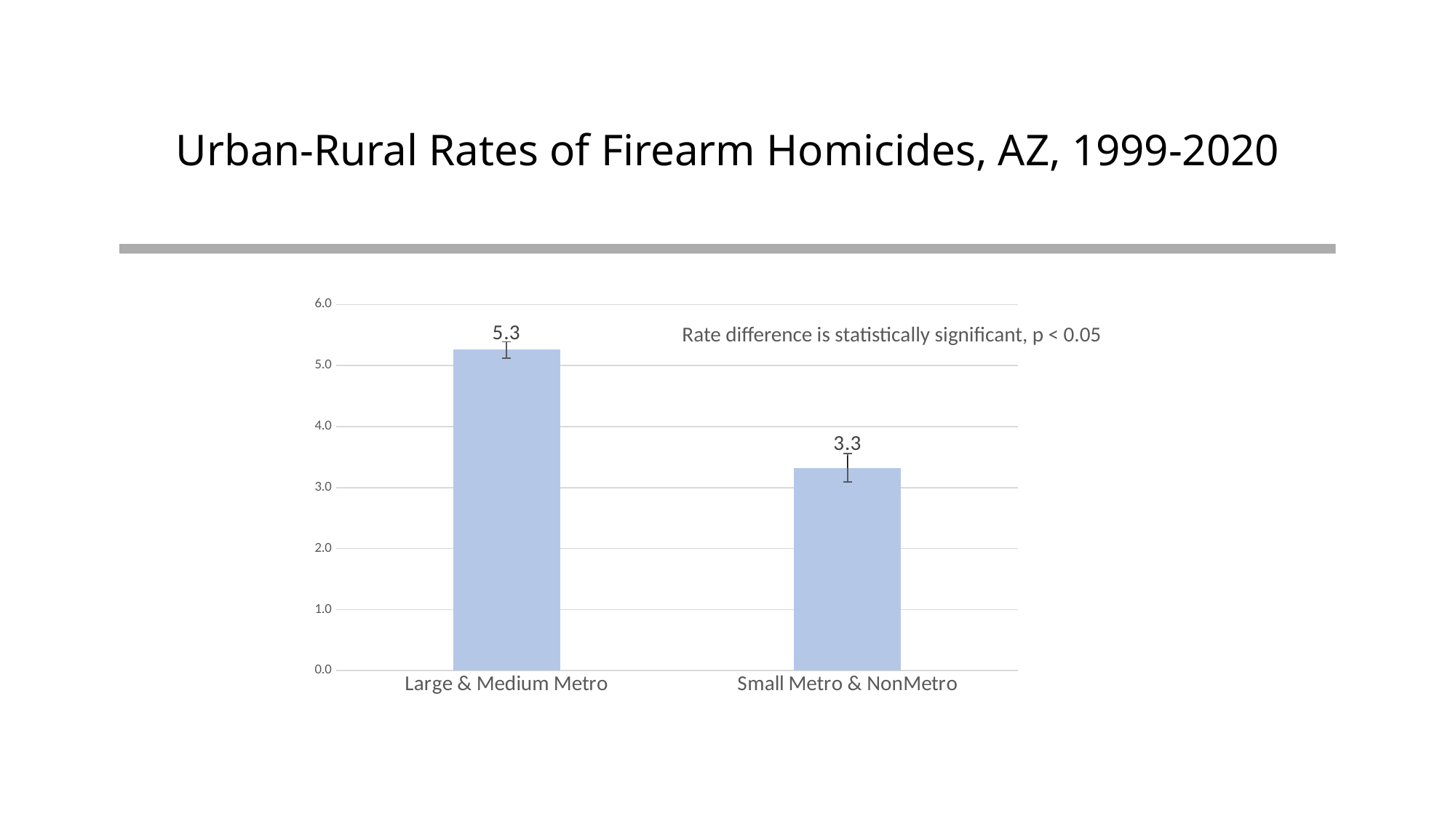
Which category has the lowest firearm homicide rate? Small Metro & NonMetro What is the firearm homicide rate for Small Metro & NonMetro? 3.3 Is the value for Large & Medium Metro greater or less than 5.0? greater How many categories are shown on the chart? 2 What is the firearm homicide rate for Large & Medium Metro? 5.3 Which category has the highest firearm homicide rate? Large & Medium Metro What is the difference between the Large & Medium Metro rate and the Small Metro & NonMetro rate? 2.0 What does the annotation on the chart say about the rate difference? Rate difference is statistically significant, p < 0.05 Is the value for Small Metro & NonMetro greater or less than 4.0? less Which is larger, the rate for Large & Medium Metro or the rate for Small Metro & NonMetro? Large & Medium Metro What kind of chart is shown on the slide? Bar chart What is the title of the slide? Urban-Rural Rates of Firearm Homicides, AZ, 1999-2020